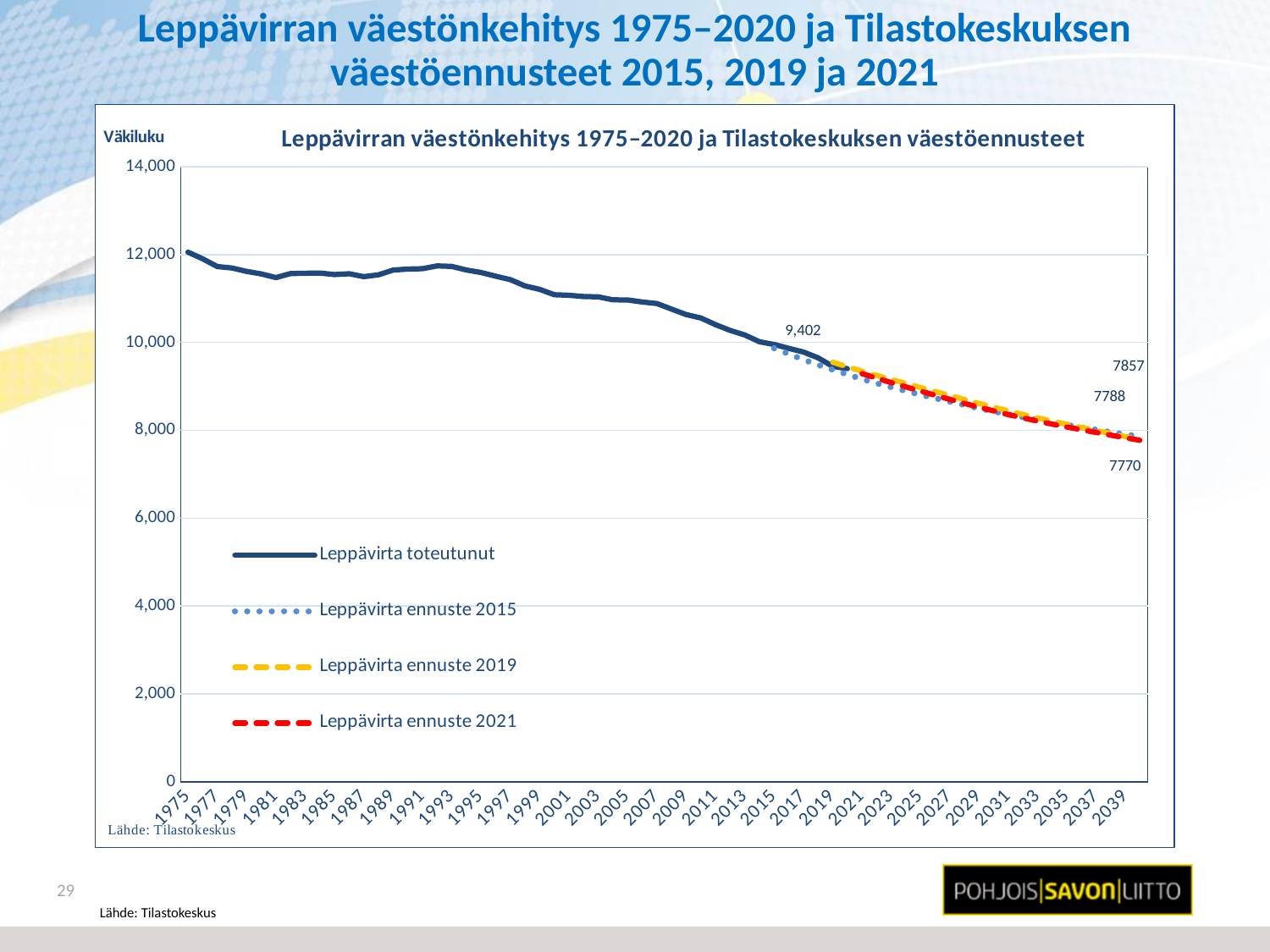
How many series does the chart legend list? 4 What are the four series named in the chart legend? Leppävirta toteutunut, Leppävirta ennuste 2015, Leppävirta ennuste 2019, Leppävirta ennuste 2021 What kind of chart is shown on the slide? line chart Which is larger, the Leppävirta toteutunut value for 1975 or for 2020? 1975 Does the Leppävirta toteutunut line rise or fall from 1975 to 2020? fall What is the highest of the three values labelled at the right end of the chart? 7857 What value is printed as a data label near 2015 on the chart? 9,402 What label is shown on the vertical axis of the chart? Väkiluku Is the Leppävirta toteutunut value for 1993 greater or less than 11,000? greater What is the lowest of the three values labelled at the right end of the chart? 7770 Is the Leppävirta toteutunut value for 2019 greater or less than 10,000? less What is the difference between the highest (7857) and lowest (7770) values labelled at the right end of the chart? 87